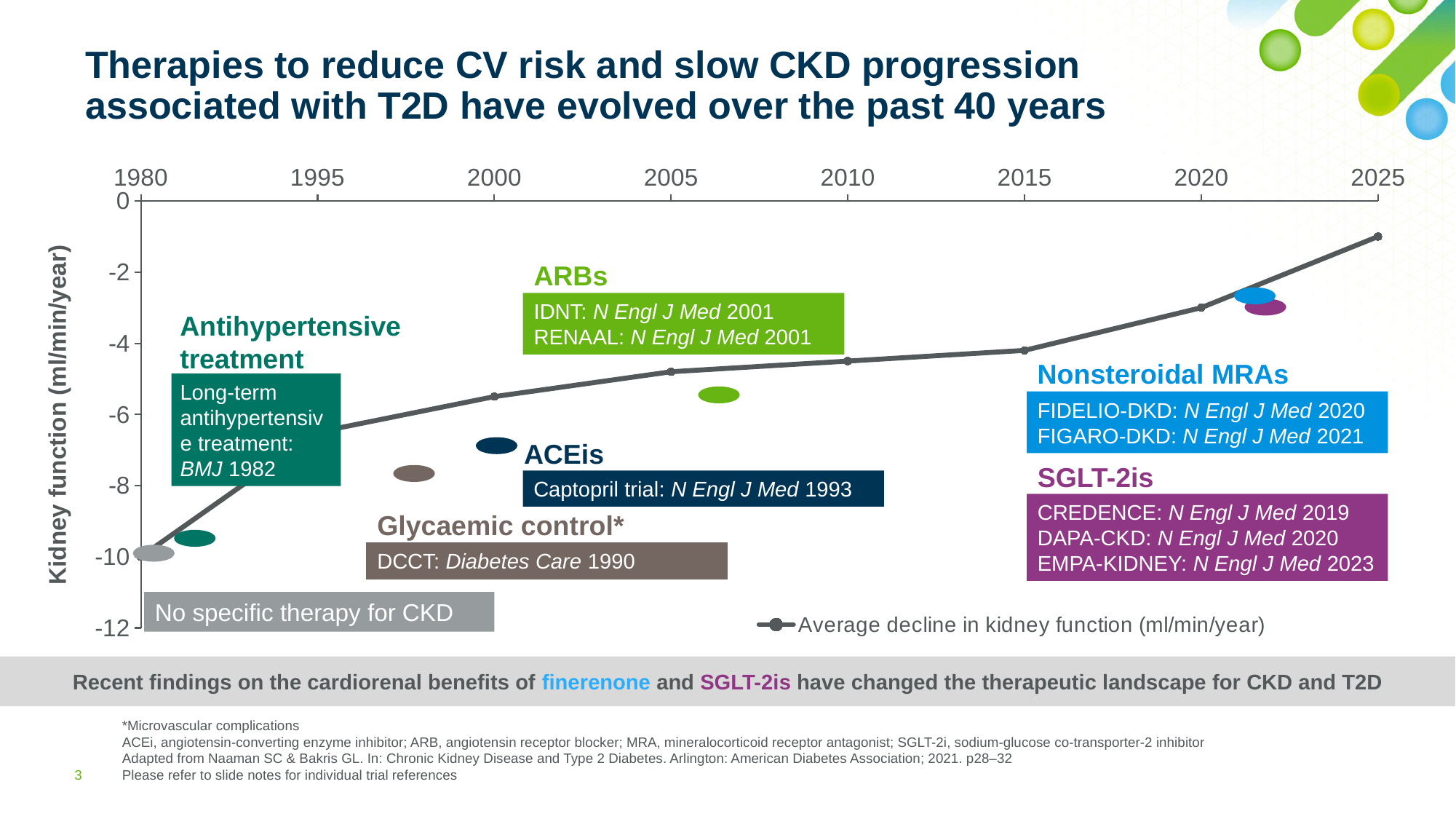
Is the plotted value for 2000 greater or less than -4? less What is the label of the series in the chart legend? Average decline in kidney function (ml/min/year) How many data points are plotted on the line? 8 Which year has the highest plotted value for average decline in kidney function? 2025 Is the plotted value for 1980 greater or less than -8? less What kind of chart is shown on the slide? Line chart Does the plotted line rise or fall from 1980 to 2025? Rise What is the title of the vertical axis of the chart? Kidney function (ml/min/year) Which year has the lowest plotted value for average decline in kidney function? 1980 Is the plotted value for 2025 greater or less than -2? greater How many series does the chart legend list? 1 Which year has the larger plotted value, 1995 or 2020? 2020